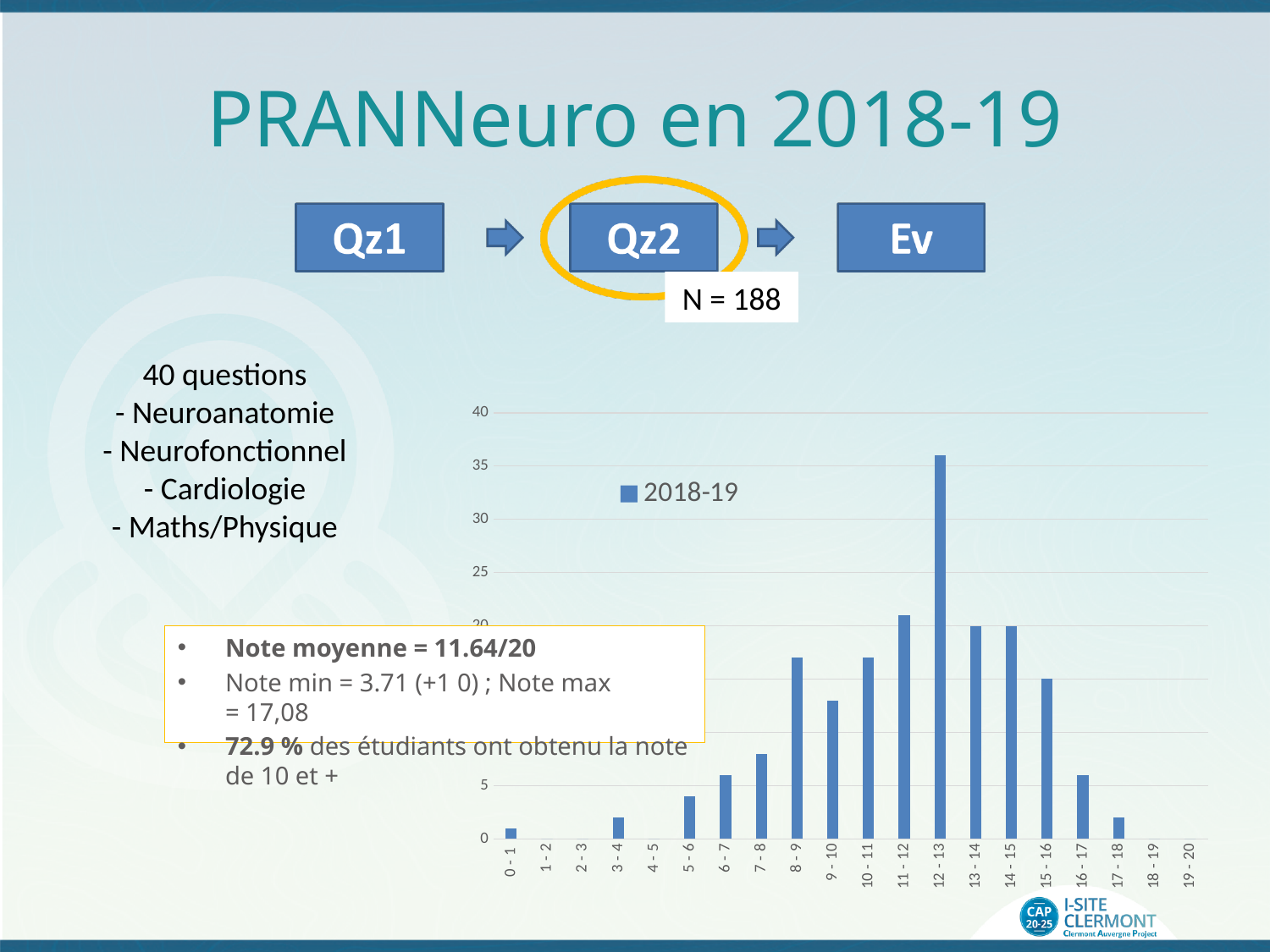
What is the name of the series shown in the chart legend? 2018-19 Is the value for the 12 - 13 score range greater or less than 30? greater Which score range has the highest bar in the chart? 12 - 13 Which is larger, the value for 8 - 9 or the value for 9 - 10? 8 - 9 Is the value for the 8 - 9 score range greater or less than 20? less Which is larger, the value for 15 - 16 or the value for 16 - 17? 15 - 16 How many series does the chart legend list? 1 What kind of chart is shown on the slide? bar chart How many score-range categories are shown on the x axis of the chart? 20 Which is larger, the value for 12 - 13 or the value for 11 - 12? 12 - 13 Is the value for the 15 - 16 score range greater or less than 10? greater